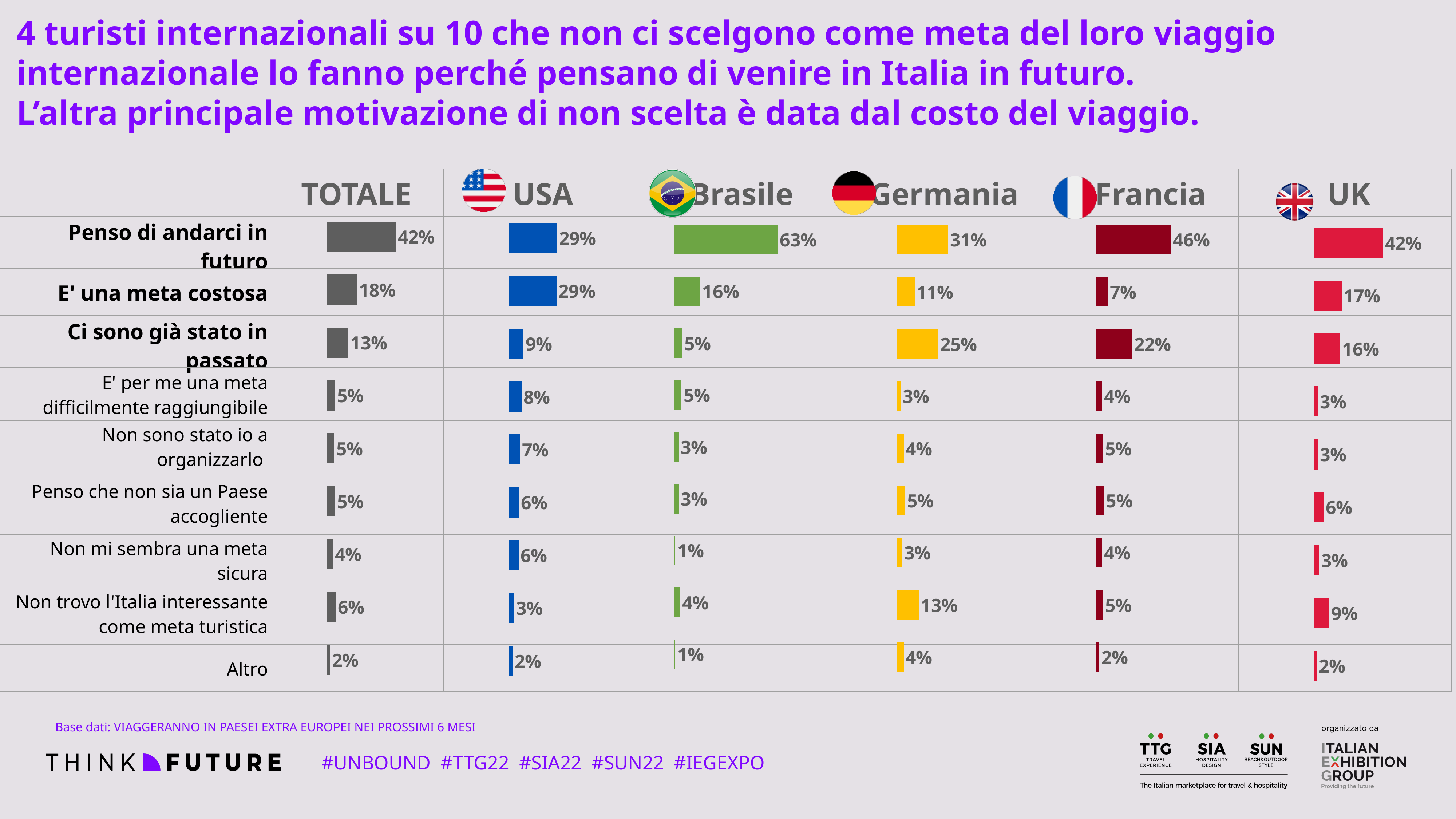
What kind of chart is used in each cell of the table? bar chart In the TOTALE column, which category has the highest value? Penso di andarci in futuro How many country columns (excluding TOTALE) are shown? 5 How many categories (rows) are shown in the table? 9 In the Francia column, which category has the lowest value? Altro In the Brasile column, what is the value for "Penso di andarci in futuro"? 63% In the USA column, what is the value for "E' una meta costosa"? 29% For "Non trovo l'Italia interessante come meta turistica", which is larger: the Germania value or the UK value? Germania Across the country columns, which country has the highest value for "Penso di andarci in futuro"? Brasile In the Germania column, what is the value for "Ci sono già stato in passato"? 25% In the UK column, what is the difference between "Penso di andarci in futuro" and "E' una meta costosa"? 25% In the Francia column, is the value for "E' una meta costosa" larger or smaller than the value for "Ci sono già stato in passato"? smaller